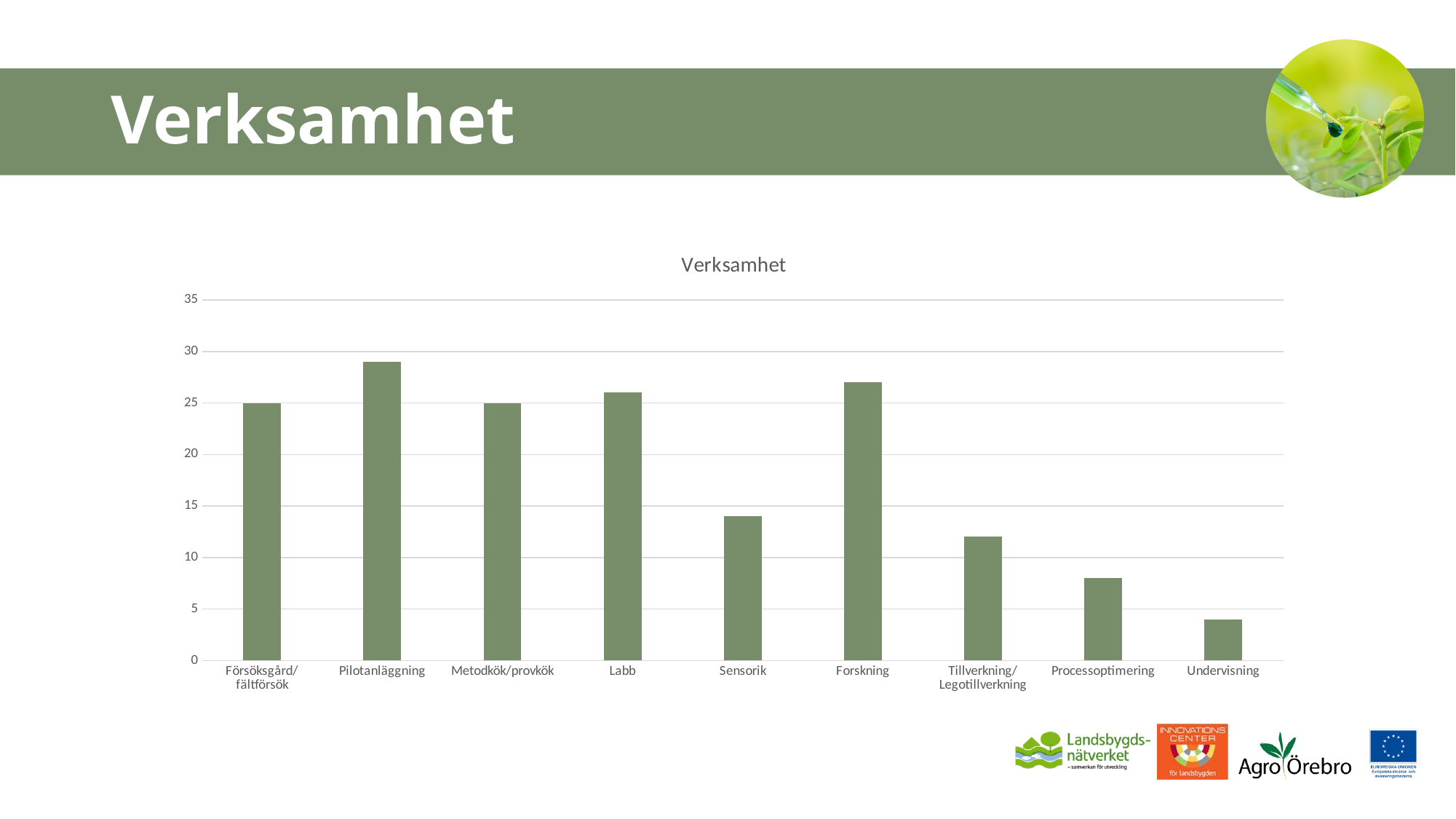
Which has a larger value, Processoptimering or Undervisning? Processoptimering Which has a larger value, Sensorik or Tillverkning/Legotillverkning? Sensorik Which category has the highest value in the chart? Pilotanläggning Is the value for Sensorik greater or less than 15? less Is the value for Processoptimering greater or less than 10? less What type of chart is shown on the slide? bar chart How many categories are shown on the x axis of the chart? 9 What is the title of the chart? Verksamhet Is the value for Pilotanläggning greater or less than 25? greater Which category has the lowest value in the chart? Undervisning